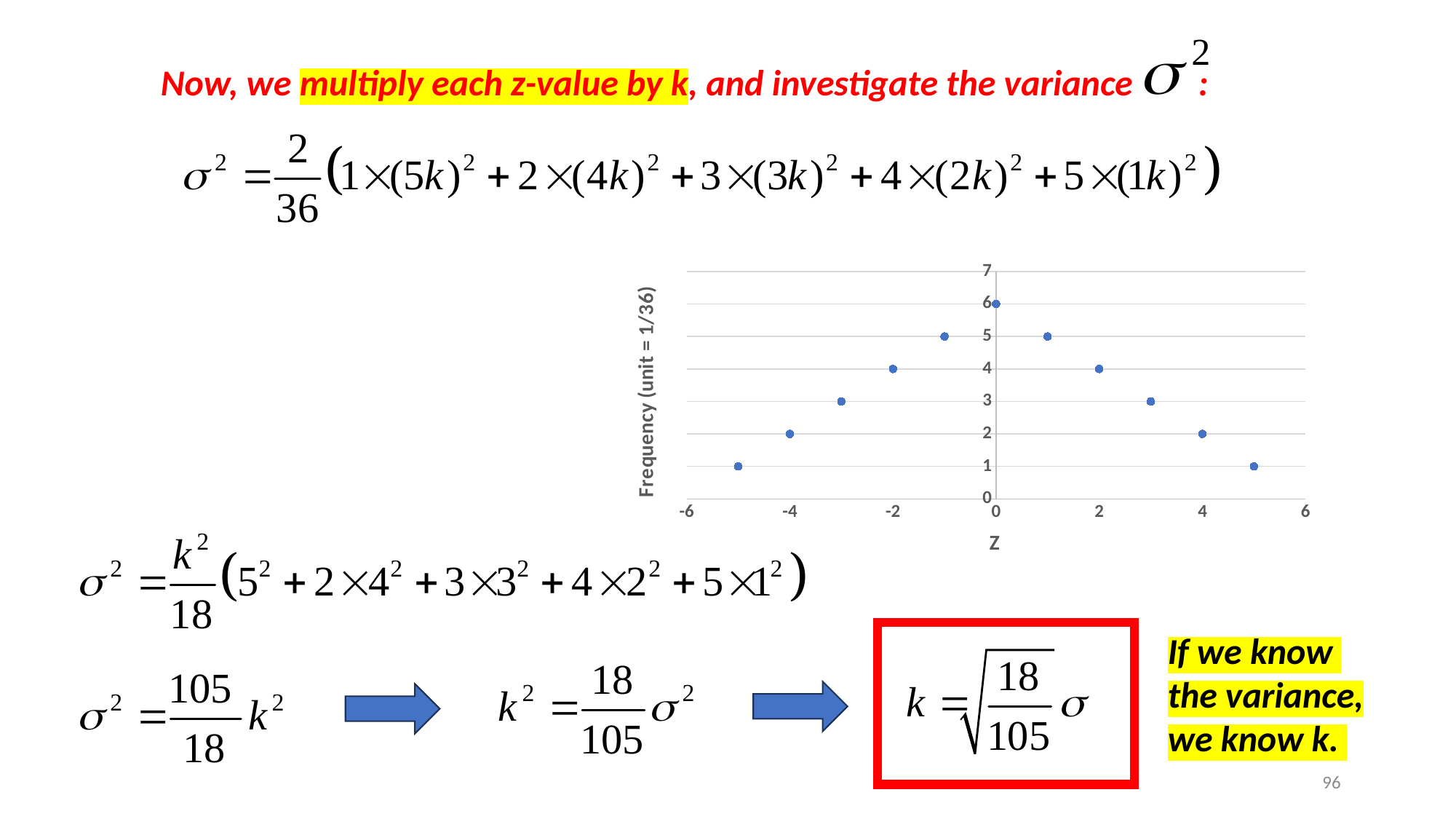
At which Z value is the frequency highest? 0 What is the difference between the frequency at Z = 0 and the frequency at Z = 4? 4 What is the frequency value at Z = 0? 6 What is the title of the horizontal axis of the chart? Z What kind of chart is shown on the slide? scatter chart Is the frequency at Z = 0 greater or less than 5? greater What is the frequency value at Z = 2? 4 How many data points are plotted in the chart? 11 Which has the larger frequency, Z = -2 or Z = -4? Z = -2 What is the frequency value at Z = -4? 2 What is the title of the vertical axis of the chart? Frequency (unit = 1/36) Do the frequency values rise or fall as Z increases from 0 to 4? fall